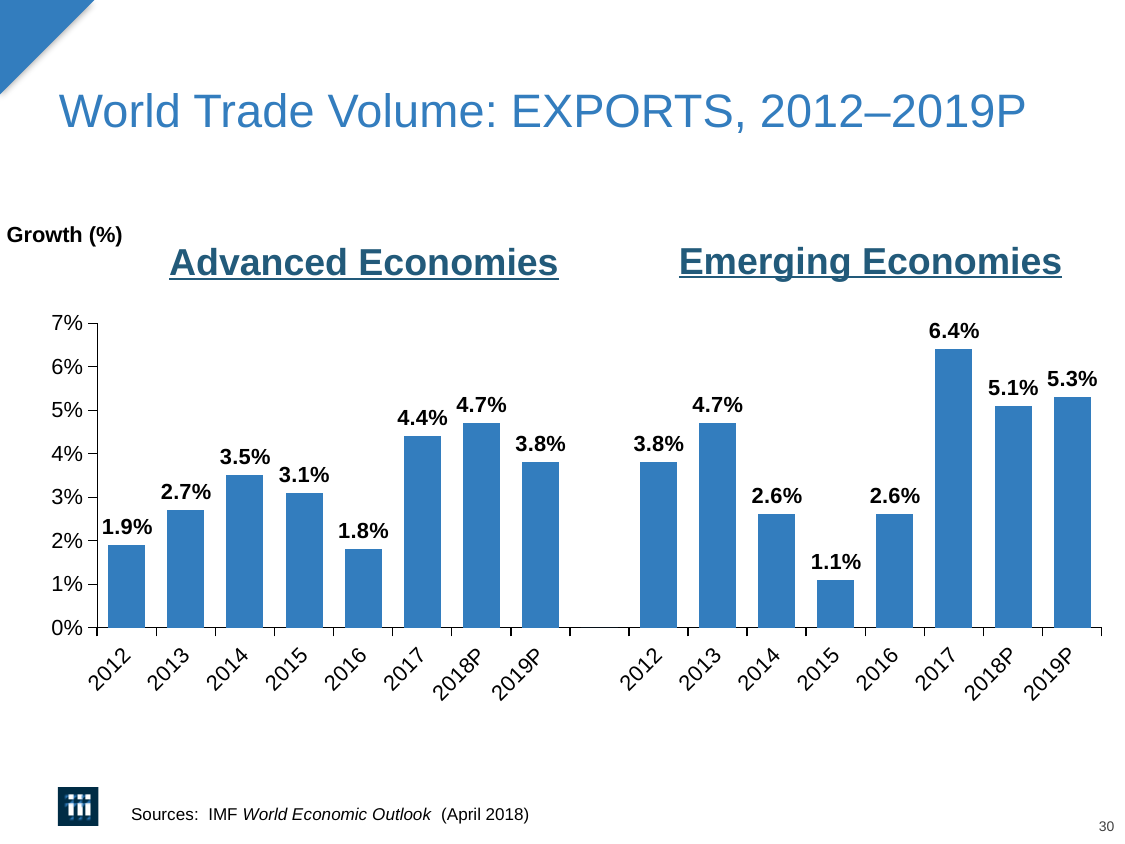
In the Emerging Economies chart, is the value for 2017 greater or less than 6%? greater In the Emerging Economies chart, which year has the highest export growth? 2017 How many years are shown on the x axis of the Advanced Economies chart? 8 In the Advanced Economies chart, what is the export growth value for 2017? 4.4% In the Advanced Economies chart, which year has the lowest export growth? 2016 In the Emerging Economies chart, what is the export growth value for 2015? 1.1% What kind of chart is used to show the Advanced Economies data? bar chart In the Advanced Economies chart, do the values rise or fall from 2014 to 2016? fall In the Emerging Economies chart, what is the difference between the 2017 value and the 2018P value? 1.3% Which is larger: the 2019P value in the Advanced Economies chart or the 2019P value in the Emerging Economies chart? Emerging Economies In the Advanced Economies chart, which year has the highest export growth? 2018P In the Advanced Economies chart, what is the difference between the 2014 value and the 2013 value? 0.8%